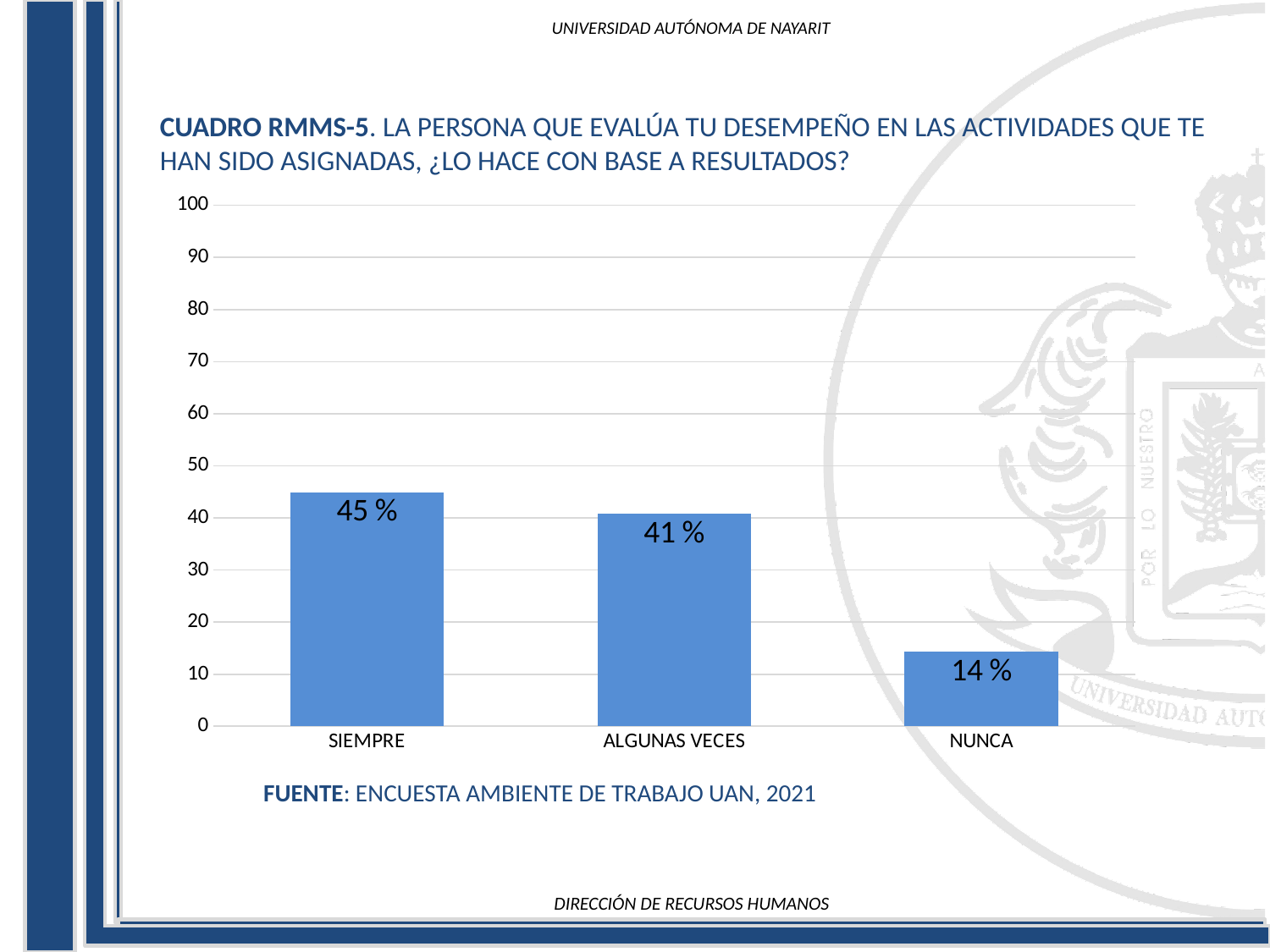
Which is larger, the value for ALGUNAS VECES or the value for NUNCA? ALGUNAS VECES What source is cited below the chart? ENCUESTA AMBIENTE DE TRABAJO UAN, 2021 What is the difference between the values for SIEMPRE and NUNCA? 31 % Which category has the highest value? SIEMPRE Which category has the lowest value? NUNCA What kind of chart is shown on the slide? bar chart What is the value for ALGUNAS VECES? 41 % Is the value for NUNCA greater or less than 20? less What is the value for NUNCA? 14 % How many categories are shown on the x axis? 3 What is the difference between the values for SIEMPRE and ALGUNAS VECES? 4 % What is the value for SIEMPRE? 45 %